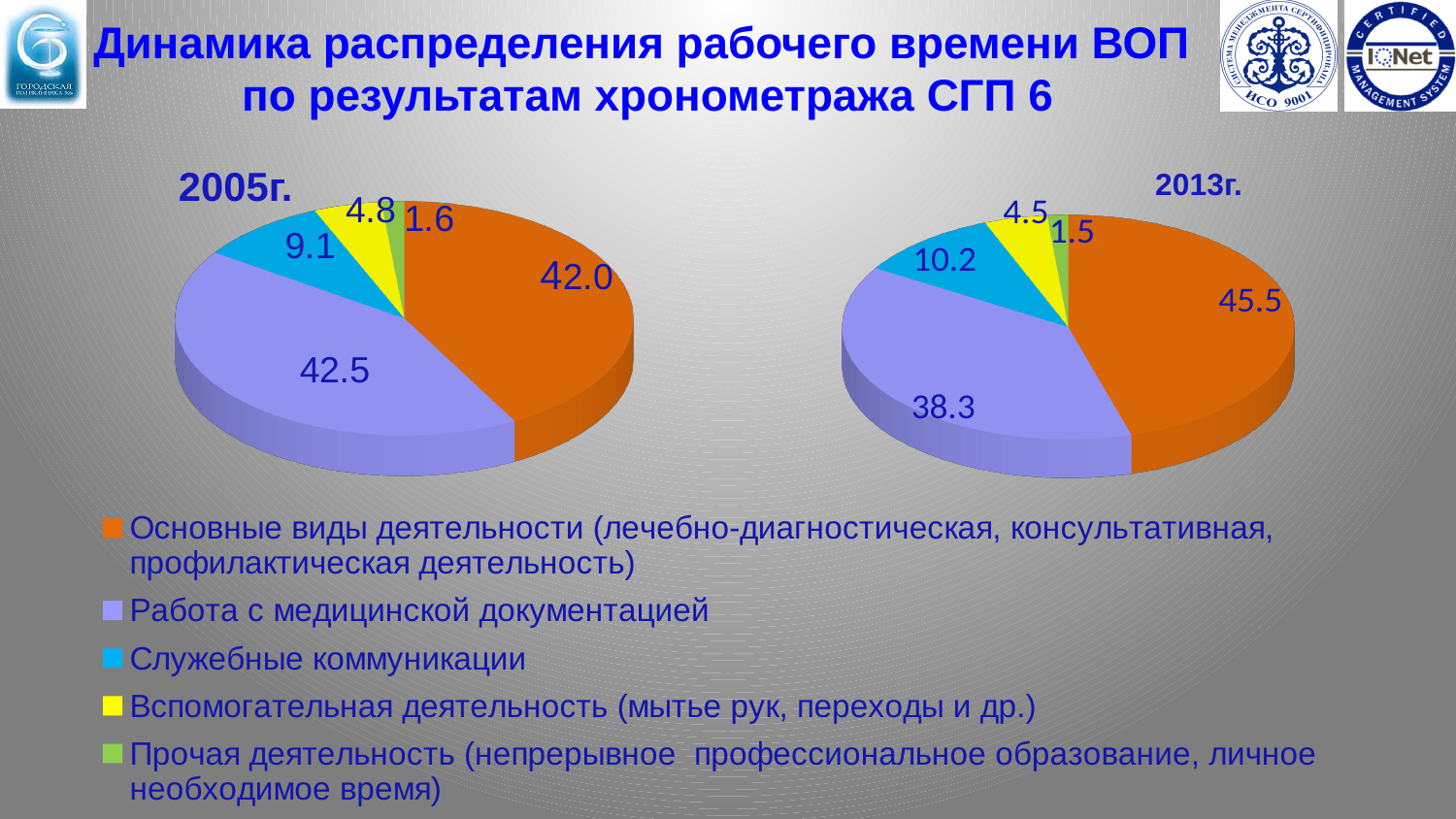
What type of chart is used for the 2005 data? Pie chart In the 2013 pie chart, what is the value for Служебные коммуникации? 10.2 Which colour represents Служебные коммуникации in the legend? Blue In the 2005 pie chart, which category has the smallest slice? Прочая деятельность How many slices does the 2005 pie chart have? 5 In the 2013 pie chart, what is the value for Основные виды деятельности? 45.5 How many entries does the legend list? 5 Which is larger in the 2013 pie chart: Служебные коммуникации or Вспомогательная деятельность? Служебные коммуникации In the 2005 pie chart, what is the value for Вспомогательная деятельность? 4.8 In the 2005 pie chart, what is the value for Работа с медицинской документацией? 42.5 In the 2013 pie chart, which category has the largest slice? Основные виды деятельности What is the difference between the 2013 values for Основные виды деятельности and Работа с медицинской документацией? 7.2